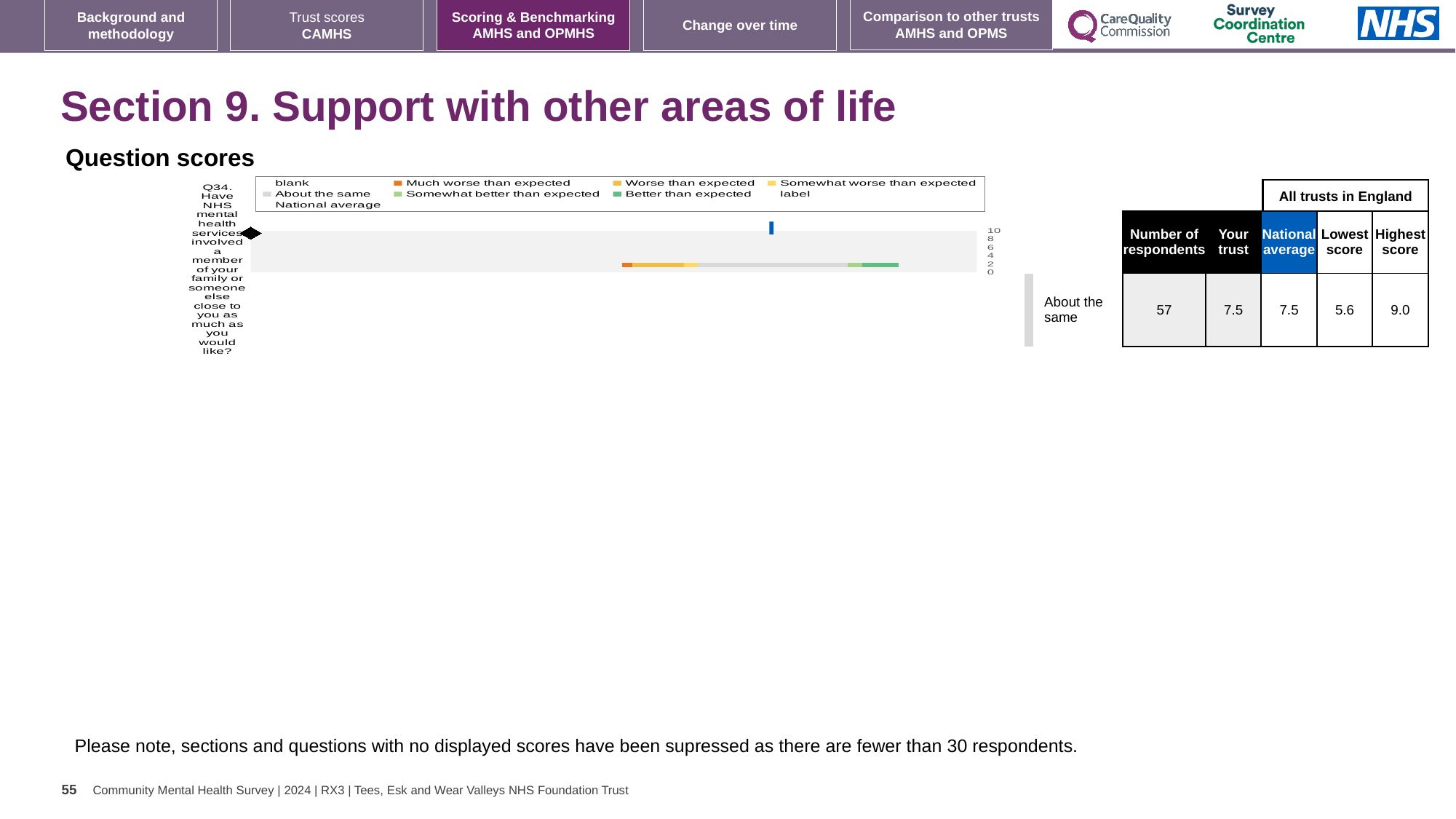
What kind of chart is shown under 'Question scores'? bar chart What is the difference between the Highest score and the Lowest score for Q34 in the table beside the chart? 3.4 According to the table beside the chart, what is the 'Your trust' score for Q34? 7.5 According to the table beside the chart, what is the Highest score among all trusts in England for Q34? 9.0 Which question is plotted in the Question scores chart? Q34. Have NHS mental health services involved a member of your family or someone else close to you as much as you would like? According to the table beside the chart, what is the Lowest score among all trusts in England for Q34? 5.6 Is the National average marker for Q34 in the chart greater or less than 8? less What is the highest value shown on the score axis of the Question scores chart? 10 According to the table beside the chart, how many respondents answered Q34? 57 According to the table beside the chart, what is the National average score for Q34? 7.5 Is the National average marker for Q34 in the chart greater or less than 6? greater How many questions (categories) are plotted in the Question scores chart? 1